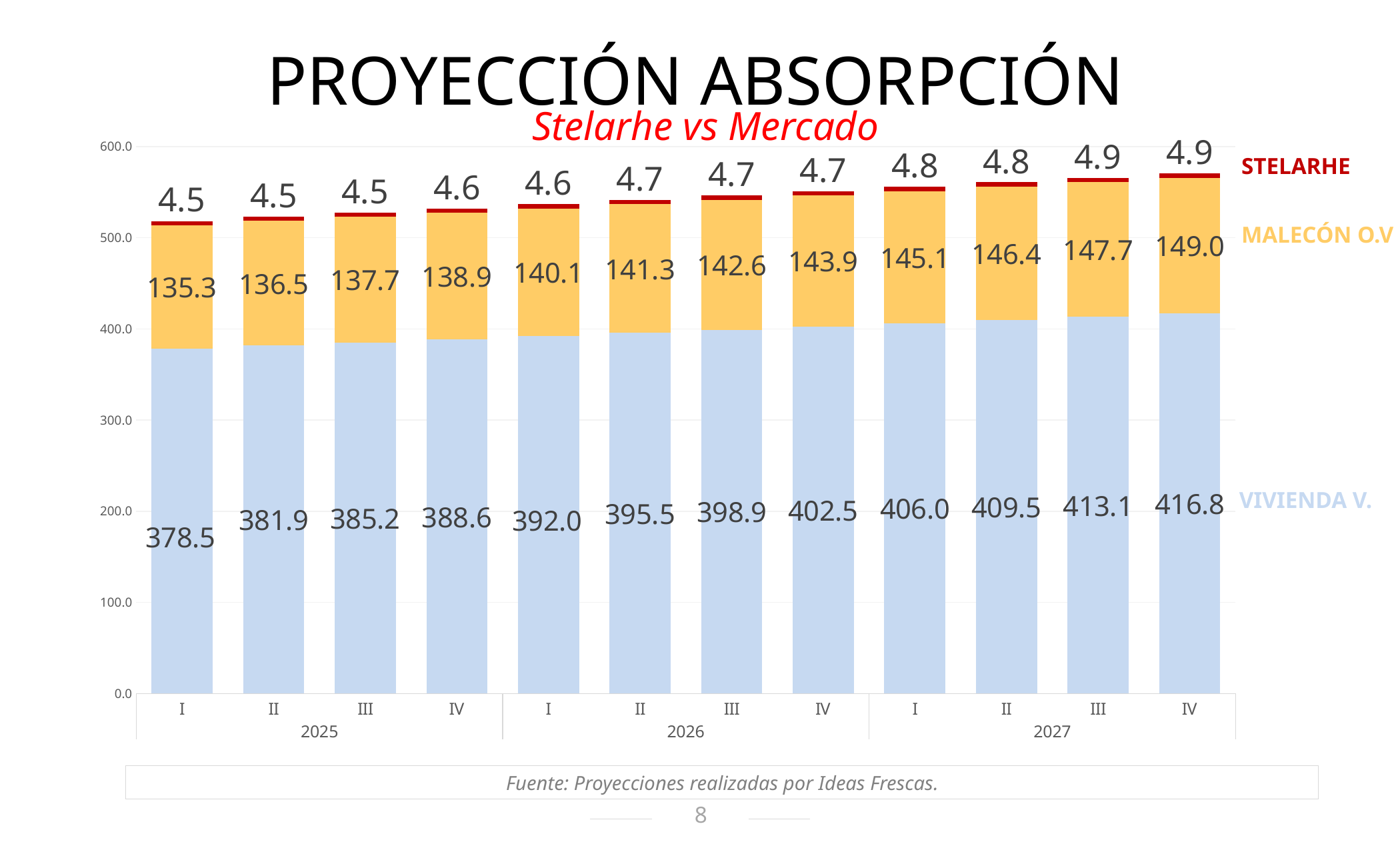
Do the VIVIENDA V. values rise or fall from 2025 to 2027? rise In which quarter is the MALECÓN O.V value lowest? I 2025 What is the value for STELARHE in quarter II of 2026? 4.7 What is the value for VIVIENDA V. in quarter III of 2026? 398.9 How many quarters are plotted on the x axis? 12 What is the total of the stacked bar for quarter I of 2025? 518.3 Which is larger, the MALECÓN O.V value in quarter I of 2026 or in quarter IV of 2025? I 2026 How many series does the chart show? 3 What is the value for VIVIENDA V. in quarter I of 2025? 378.5 What is the difference between the VIVIENDA V. value in quarter IV of 2027 and in quarter I of 2025? 38.3 What is the value for MALECÓN O.V in quarter IV of 2027? 149.0 In which quarter is the VIVIENDA V. value highest? IV 2027